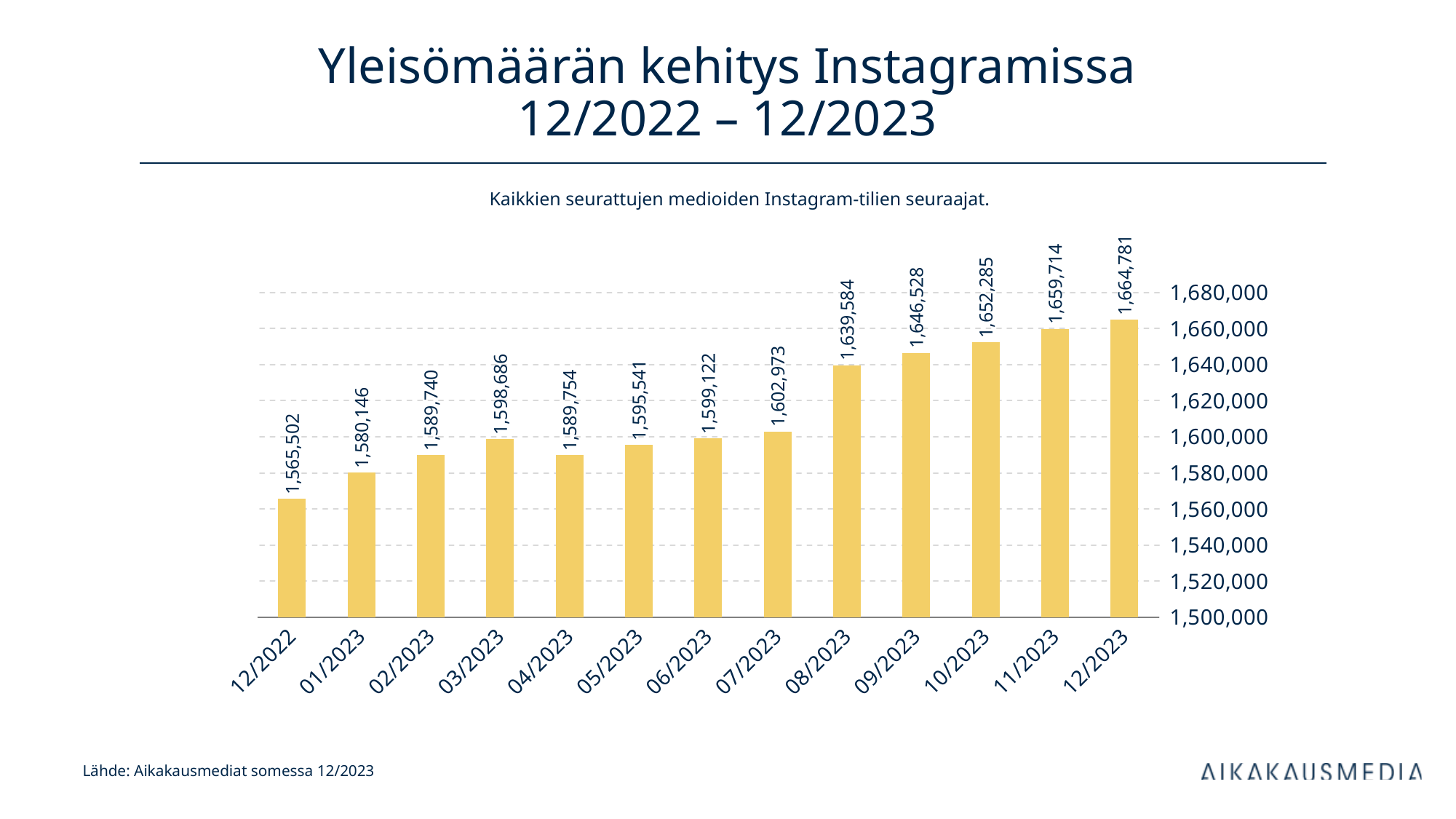
What is the difference between the values for 12/2023 and 12/2022? 99,279 What is the title of the chart? Yleisömäärän kehitys Instagramissa 12/2022 – 12/2023 How many months are shown on the x axis? 13 Do the values generally rise or fall from 12/2022 to 12/2023? rise Which month has the lowest value? 12/2022 What is the value for 12/2022? 1,565,502 Is the value for 07/2023 greater or less than 1,600,000? greater What is the value for 04/2023? 1,589,754 What kind of chart is shown on the slide? bar chart Which month has the highest value? 12/2023 What is the value for 08/2023? 1,639,584 Which is larger, the value for 03/2023 or the value for 04/2023? 03/2023